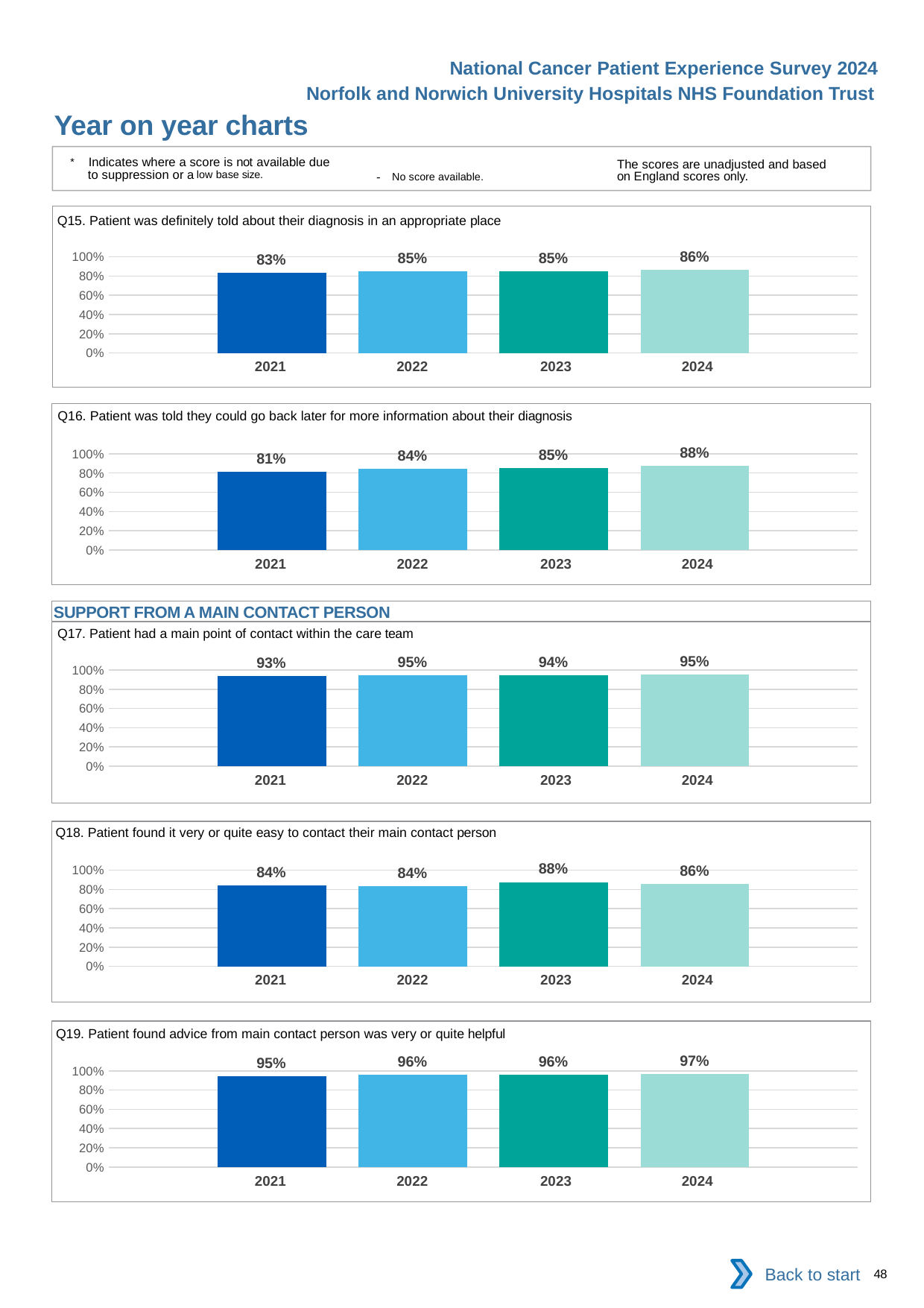
In the Q18 chart (Patient found it very or quite easy to contact their main contact person), which year has the highest value? 2023 In the Q17 chart (Patient had a main point of contact within the care team), what is the value for 2023? 94% What kind of chart is the Q16 chart? bar chart In the Q18 chart (Patient found it very or quite easy to contact their main contact person), is the value for 2023 larger or smaller than the value for 2024? larger How many years are shown on the x axis of the Q15 chart? 4 In the Q19 chart (Patient found advice from main contact person was very or quite helpful), what is the value for 2024? 97% In the Q15 chart (Patient was definitely told about their diagnosis in an appropriate place), what is the value for 2021? 83% In the Q16 chart (Patient was told they could go back later for more information about their diagnosis), which year has the highest value? 2024 In the Q15 chart, is the value for 2024 greater or less than 80%? greater In the Q19 chart (Patient found advice from main contact person was very or quite helpful), do the values rise or fall from 2021 to 2024? rise In the Q16 chart (Patient was told they could go back later for more information about their diagnosis), what is the difference between the 2024 and 2021 values? 7 percentage points In the Q17 chart (Patient had a main point of contact within the care team), which year has the lowest value? 2021